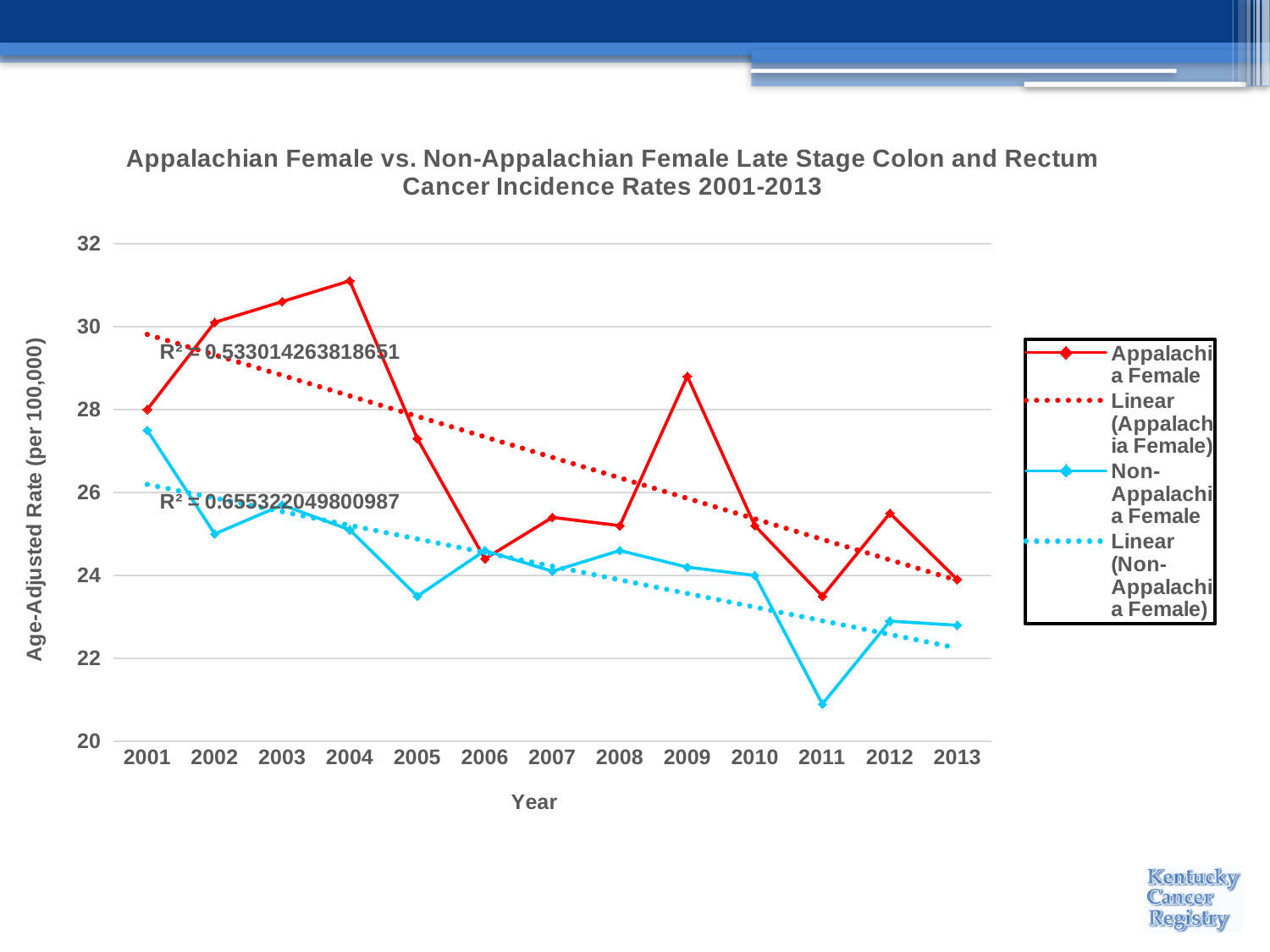
What is the label of the y axis? Age-Adjusted Rate (per 100,000) Is the value for Appalachia Female in 2004 greater or less than 30? greater Is the value for Non-Appalachia Female in 2011 greater or less than 22? less Is the value for Appalachia Female in 2009 greater or less than 28? greater In which year does the Appalachia Female series reach its highest value? 2004 How many entries does the legend list? 4 What kind of chart is shown on the slide? Line chart In which year does the Non-Appalachia Female series reach its lowest value? 2011 In 2009, which series has the larger value: Appalachia Female or Non-Appalachia Female? Appalachia Female What R² value is shown for the Linear (Appalachia Female) trendline? 0.533014263818651 Overall, do the Appalachia Female values rise or fall from 2001 to 2013? Fall How many years are plotted along the x axis? 13